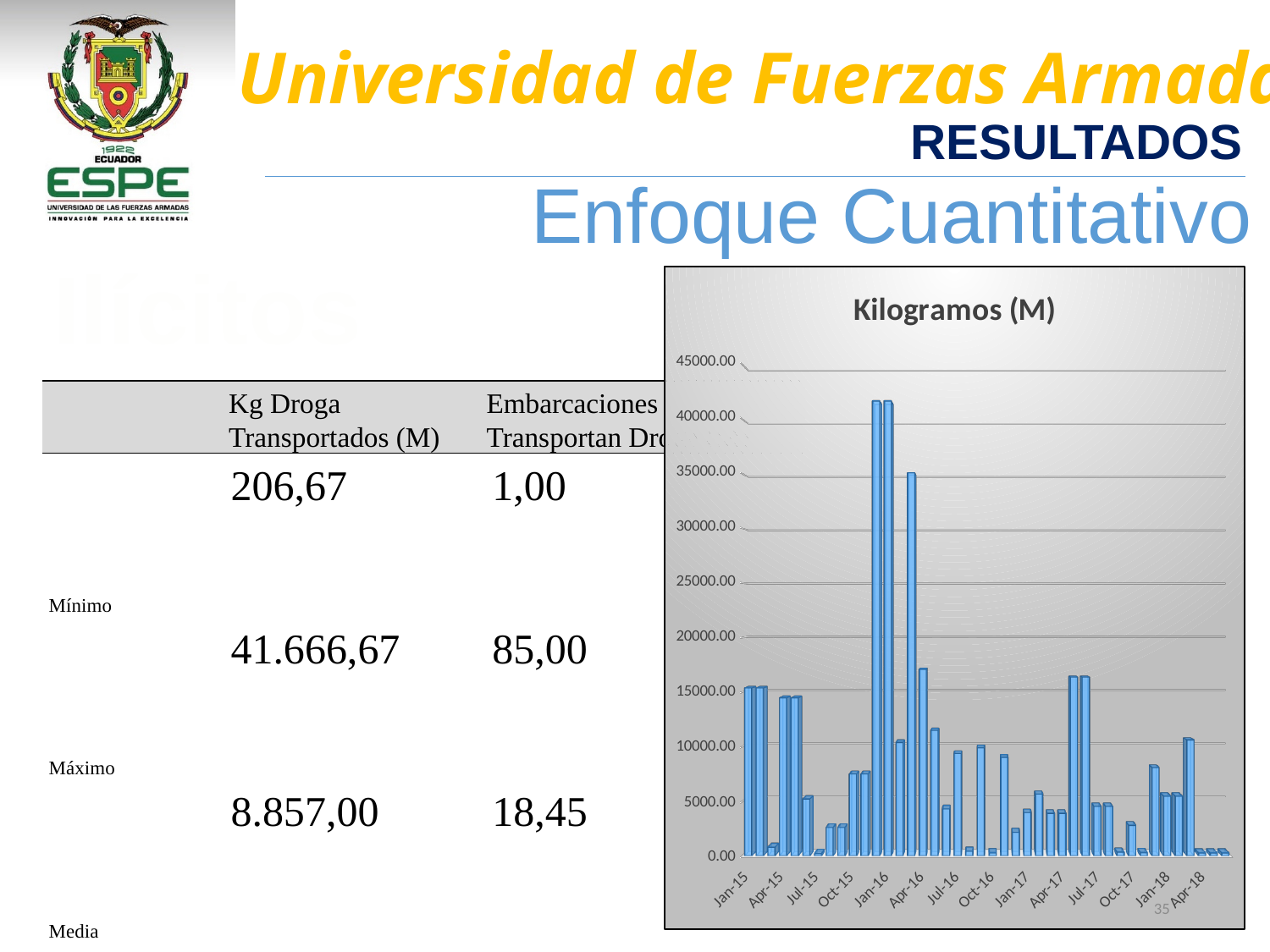
Is the tallest bar in the chart greater or less than 35000? greater Are the values in early 2018 higher or lower than the peak values in early 2016? lower What kind of chart is shown on the slide? bar chart What is the highest value shown on the chart's vertical axis? 45000.00 Is the value for Apr-18 greater or less than 5000? less Is the value for Jan-15 greater or less than 10000? greater Which month label on the x axis is closest to the tallest bars in the chart? Jan-16 What is the first month label on the chart's x axis? Jan-15 What is the title of the chart on the slide? Kilogramos (M)